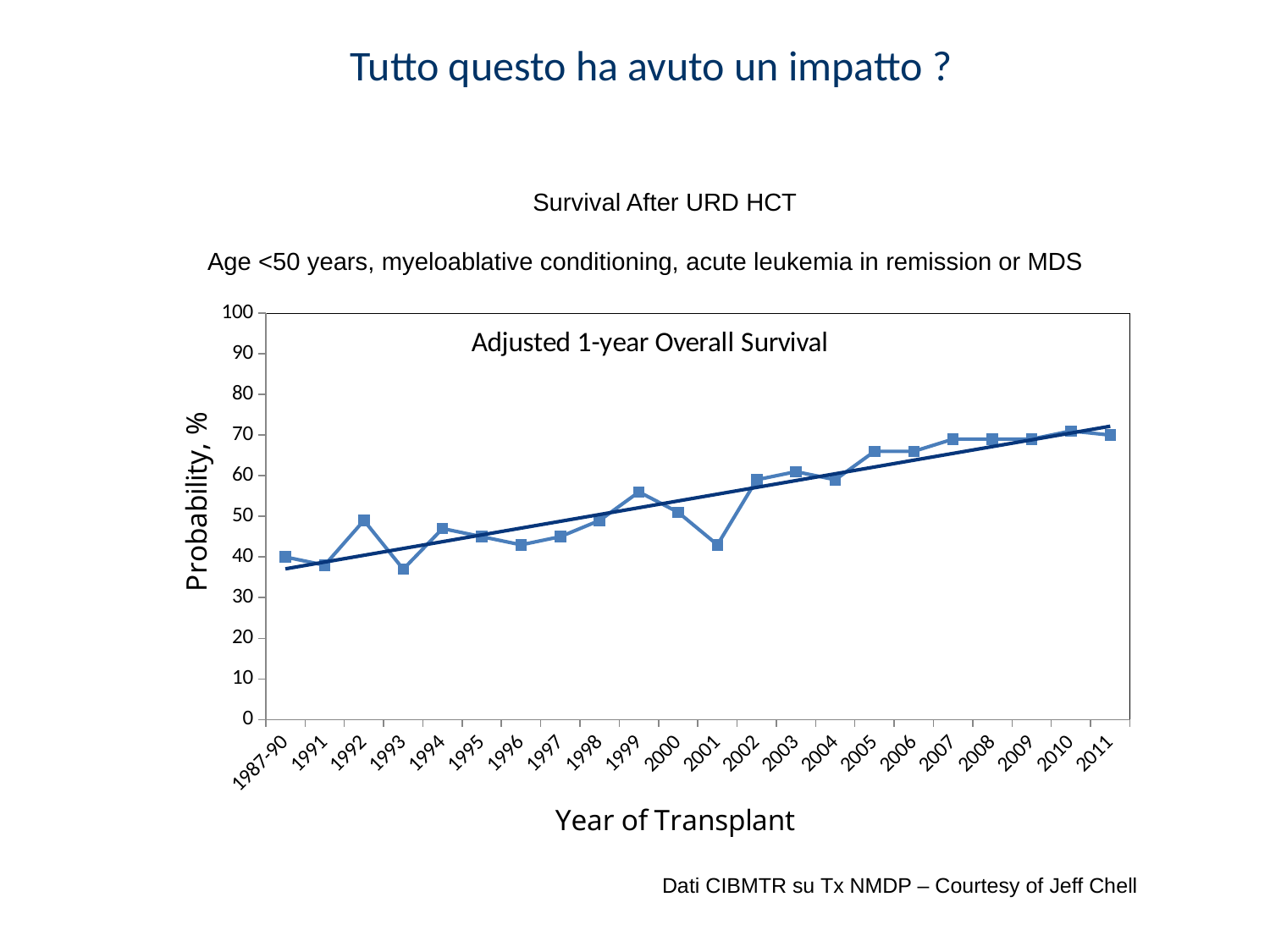
Is the value for 2009 greater or less than 60? greater Which year has the larger value, 1999 or 2001? 1999 Is the value for 2005 greater or less than 60? greater Is the value for 1999 greater or less than 50? greater Which year has the larger value, 1992 or 1993? 1992 Do the survival values generally rise or fall from 1987-90 to 2011? rise What kind of chart is shown on the slide? line chart What is the title of the y axis? Probability, % What is the title shown inside the chart area? Adjusted 1-year Overall Survival How many years (data points) are plotted along the x axis? 22